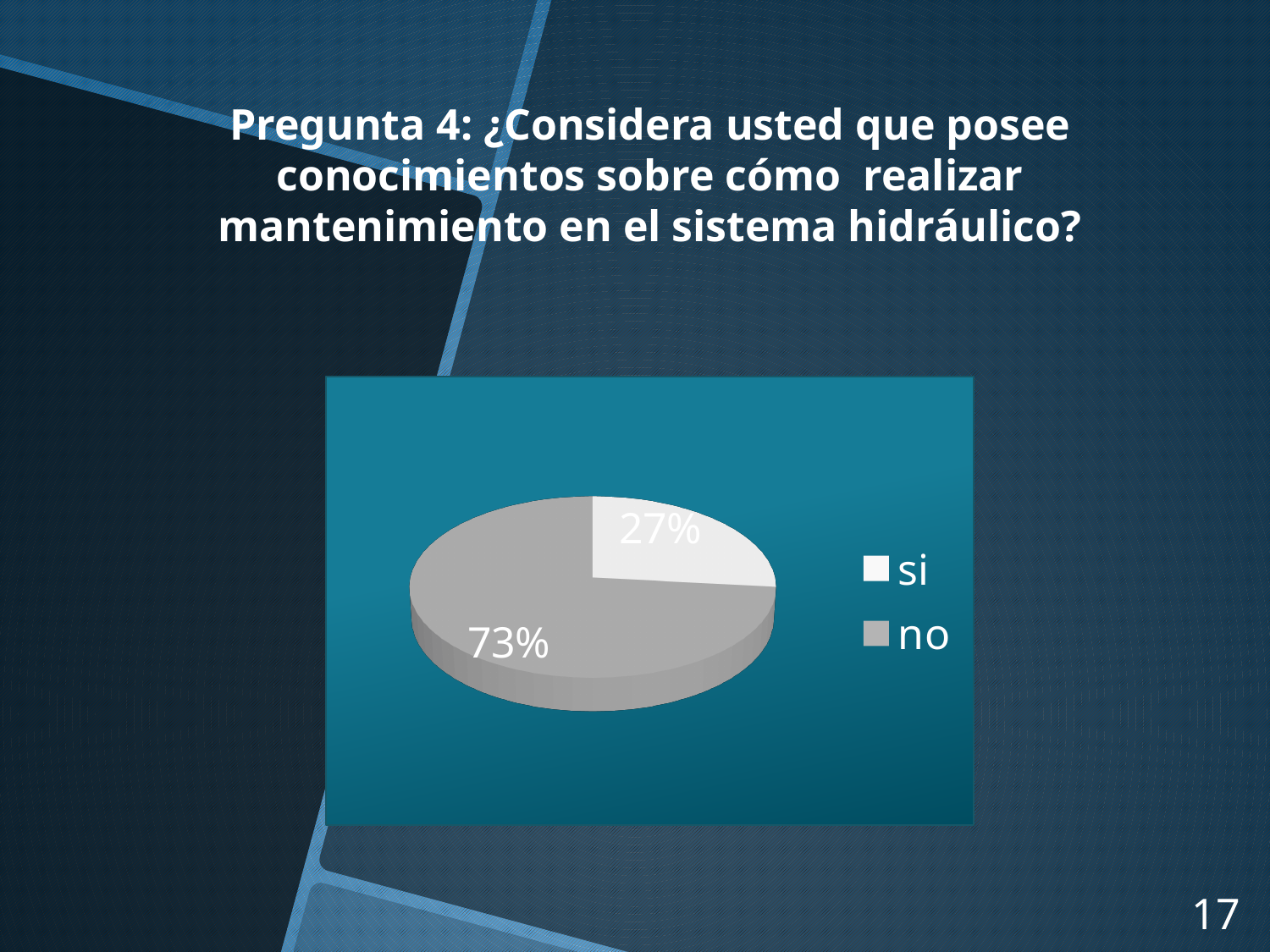
Which response has the largest share of the pie? no What percentage of respondents answered "si"? 27% Which is larger, the share for "si" or the share for "no"? no How many slices does the pie chart have? 2 What colour is the "no" slice in the pie chart? grey What colour is the "si" slice in the pie chart? white What percentage of respondents answered "no"? 73% What kind of chart is shown on the slide? pie chart Which response has the smallest share of the pie? si How many entries does the legend list? 2 What is the difference in percentage points between the "no" and "si" slices? 46 What share of the pie does the "no" slice represent? 73%